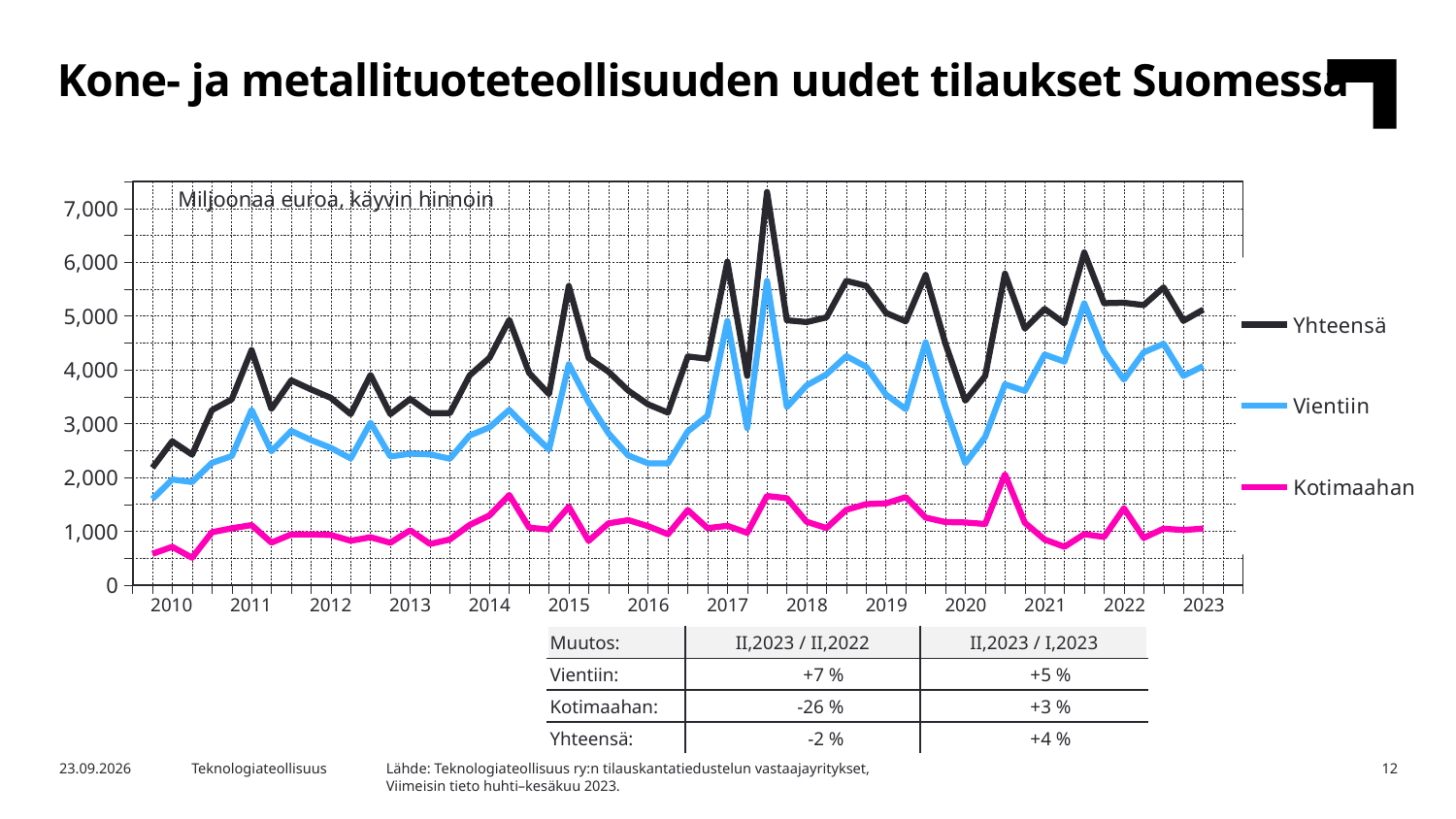
In which year does the Yhteensä series reach its highest peak? 2017 How many series does the legend list? 3 Is the peak value of Yhteensä in 2017 greater or less than 6,000? greater Is the value for Vientiin at its 2020 low point greater or less than 3,000? less Which series has the lowest values throughout the chart? Kotimaahan How many years are labelled on the x axis? 14 Is the value for Kotimaahan at the start of 2010 greater or less than 1,000? less What kind of chart is shown on the slide? line chart Does the Yhteensä series overall rise or fall from 2010 to 2023? rise What is the title of the chart? Kone- ja metallituoteteollisuuden uudet tilaukset Suomessa Which series has the highest values throughout the chart? Yhteensä What unit is stated in the chart's subtitle? Miljoonaa euroa, käyvin hinnoin